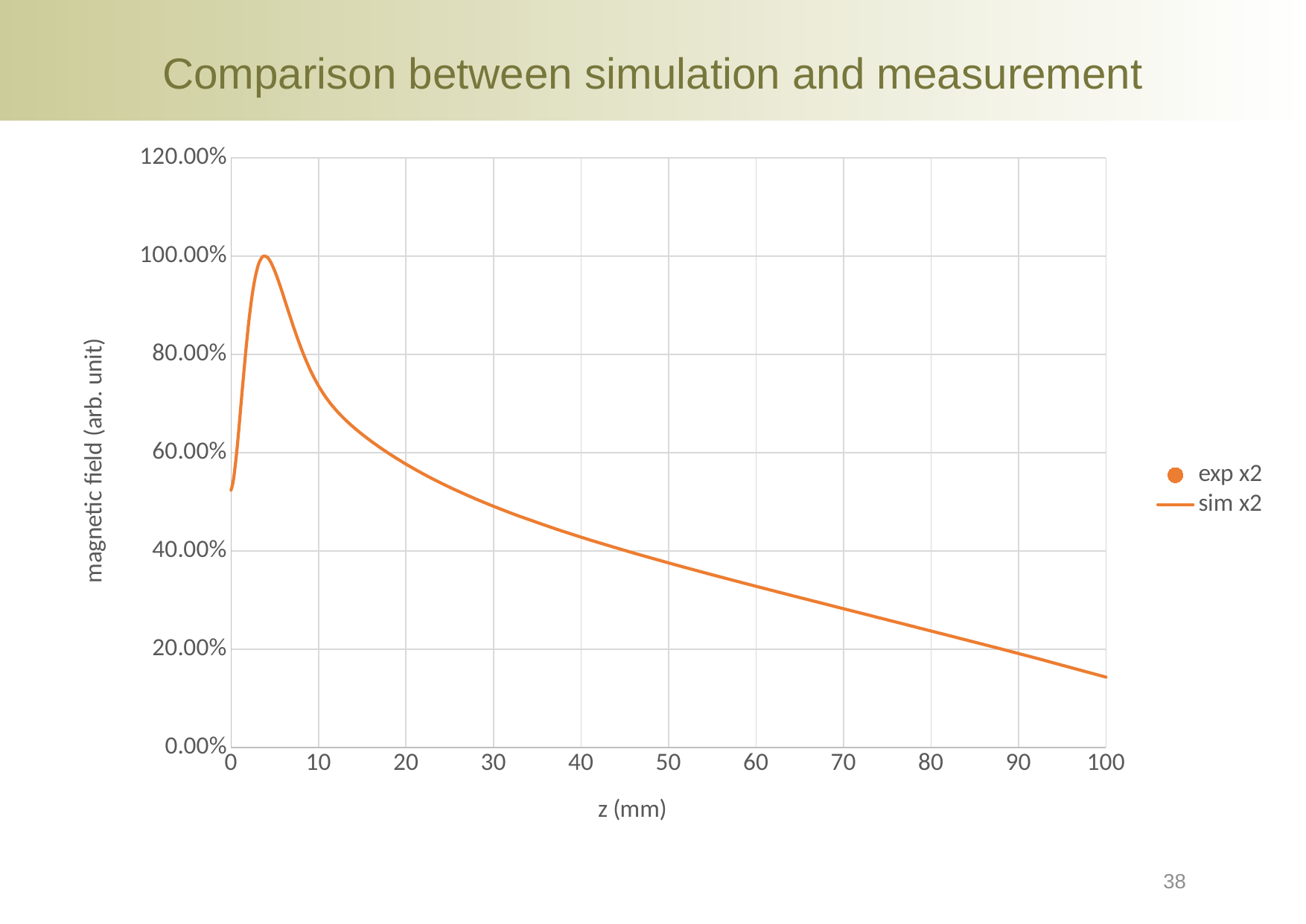
Is the value of the sim x2 curve at z = 50 mm greater or less than 40.00%? less Is the value of the sim x2 curve at z = 100 mm greater or less than 20.00%? less Is the value of the sim x2 curve at z = 10 mm greater or less than 60.00%? greater Is the value of the sim x2 curve at z = 30 mm larger or smaller than its value at z = 70 mm? larger After its peak, does the sim x2 curve rise or fall as z increases from 10 mm to 100 mm? fall What kind of chart is shown on the slide? line chart What are the two series named in the legend? exp x2 and sim x2 What is the title of the chart? Comparison between simulation and measurement How many series does the legend list? 2